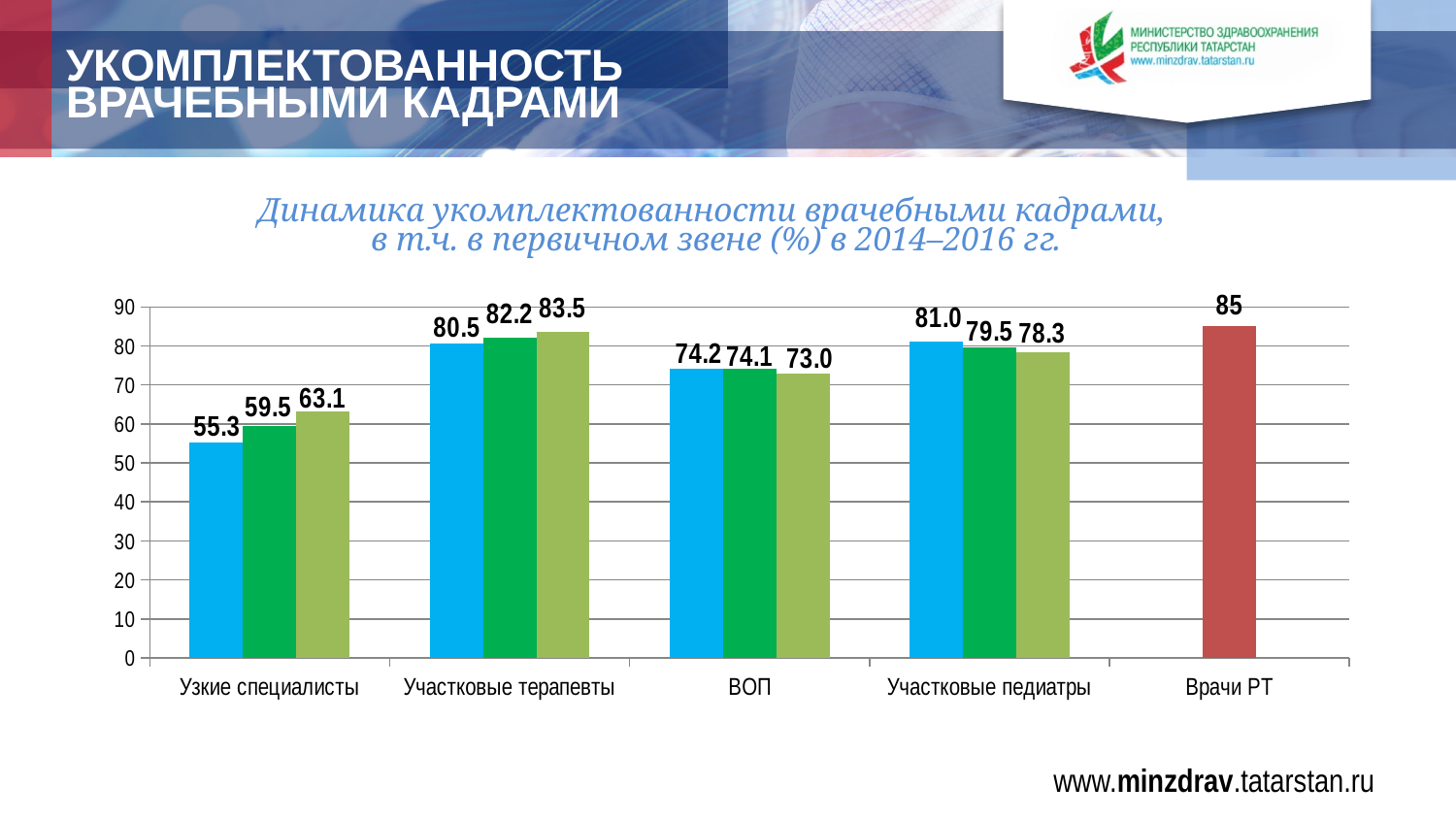
How many categories are shown on the x axis? 5 What kind of chart is shown on the slide? bar chart What is the value of the second (green) bar for ВОП? 74.1 Do the three bars for Участковые педиатры rise or fall from left to right? fall Which is larger: the first bar for Участковые педиатры or the first bar for Участковые терапевты? Участковые педиатры What is the value of the first (blue) bar for Узкие специалисты? 55.3 Do the three bars for Участковые терапевты rise or fall from left to right? rise What is the difference between the third and first bars for Узкие специалисты? 7.8 Which category has the lowest value on the chart? Узкие специалисты Which category has the highest value on the chart? Врачи РТ What is the value of the third (olive) bar for Участковые терапевты? 83.5 What is the value shown for Врачи РТ? 85